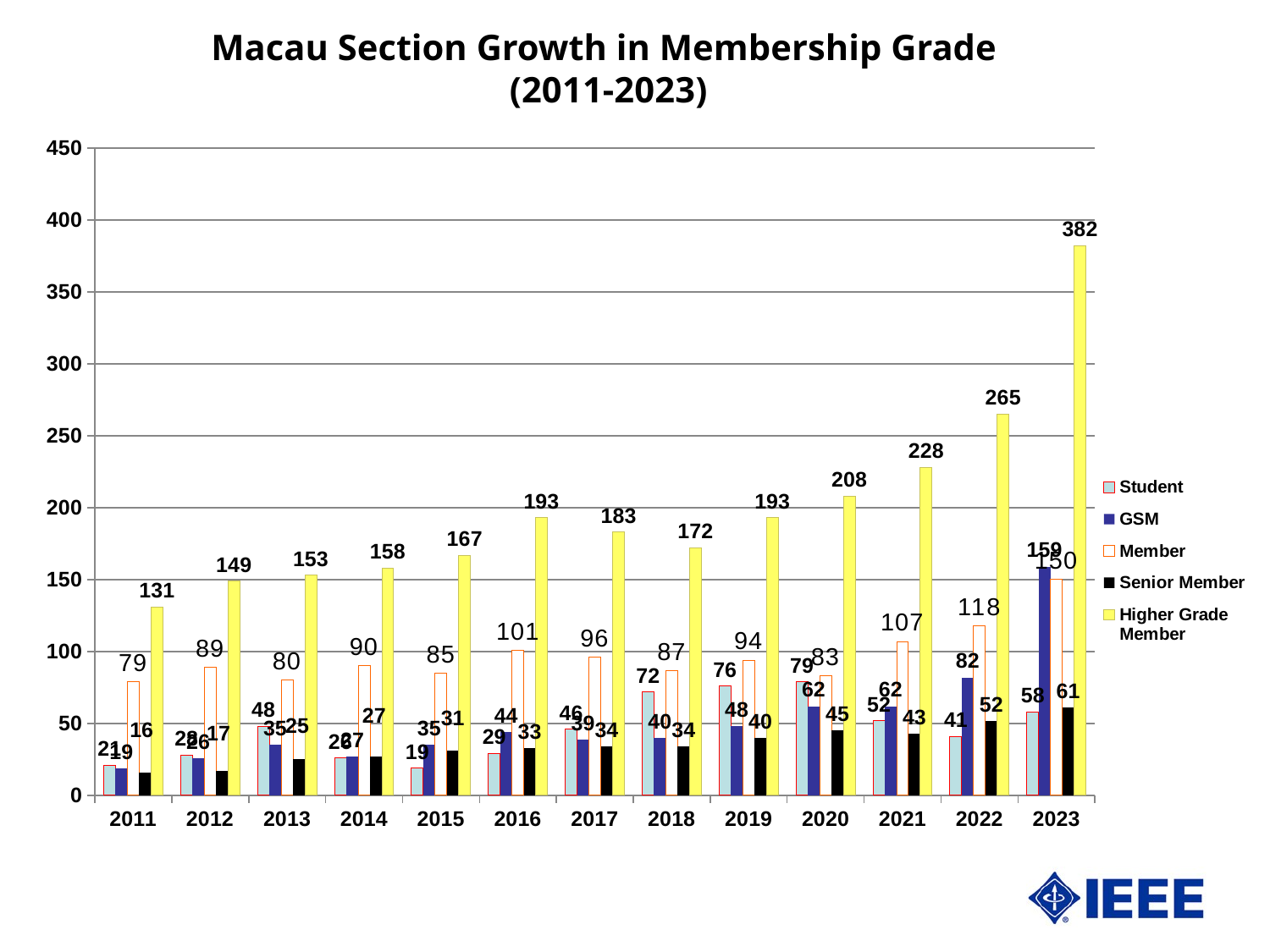
What is the Senior Member value for 2023? 61 What is the Higher Grade Member value for 2023? 382 What is the difference between the Higher Grade Member values for 2023 and 2022? 117 In which year is the Higher Grade Member value lowest? 2011 In 2019, which is larger: the Student value or the GSM value? Student What is the title of the chart? Macau Section Growth in Membership Grade (2011-2023) What is the Member value for 2022? 118 Do the Higher Grade Member values rise or fall from 2019 to 2023? rise How many years are shown on the x axis? 13 What kind of chart is shown on the slide? bar chart In which year is the Higher Grade Member value highest? 2023 How many series does the legend list? 5